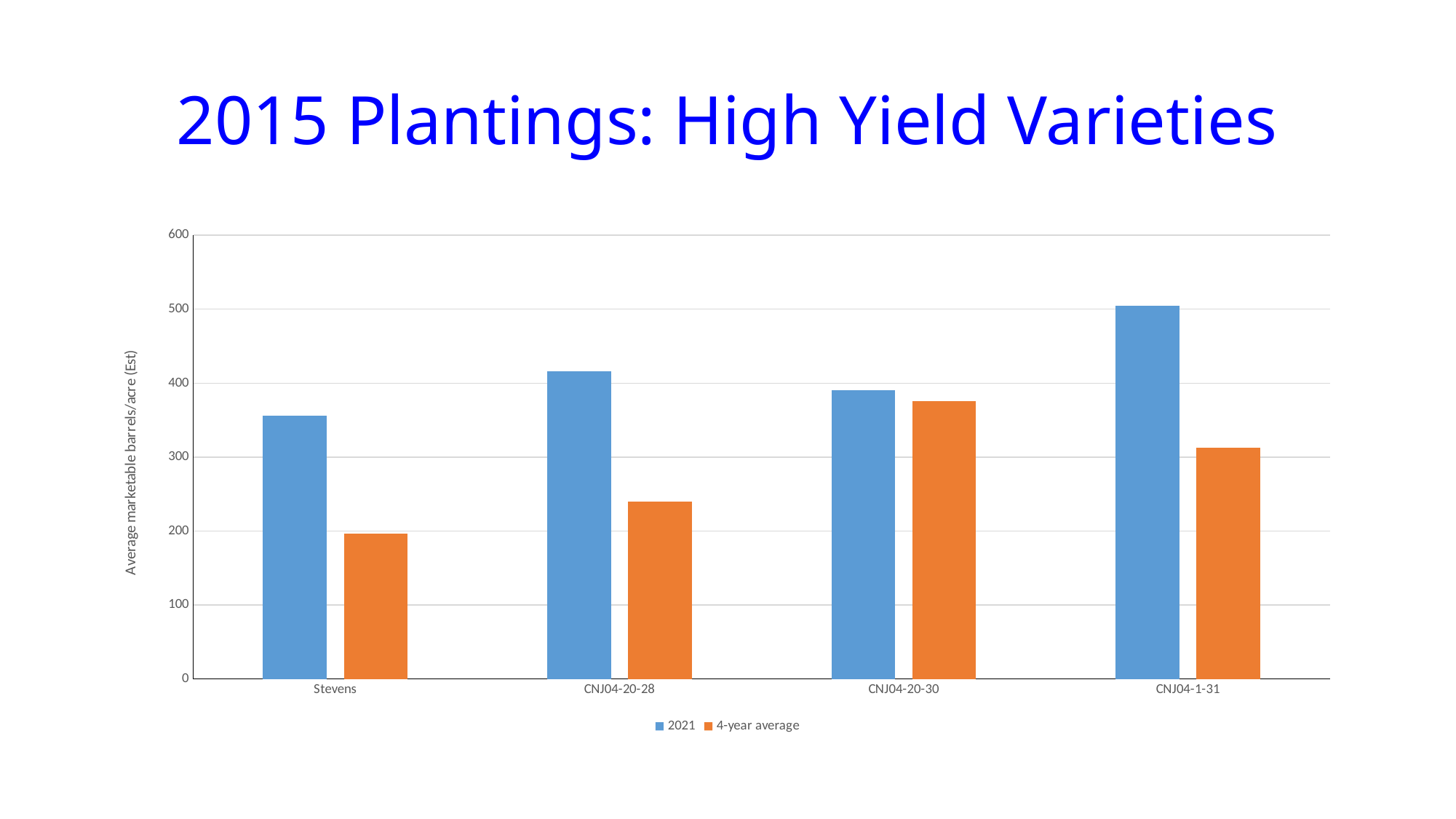
What kind of chart is shown on the slide? bar chart Which variety has the lowest 4-year average value? Stevens Which is larger: the 2021 value for Stevens or the 2021 value for CNJ04-20-28? CNJ04-20-28 How many series does the legend list? 2 Which variety has the lowest 2021 value? Stevens Which variety has the highest 4-year average value? CNJ04-20-30 Which variety has the highest 2021 value? CNJ04-1-31 How many varieties are shown on the x axis of the chart? 4 Is the 4-year average value for CNJ04-1-31 greater or less than 400? less What is the title of the chart slide? 2015 Plantings: High Yield Varieties Is the 4-year average value for Stevens greater or less than 300? less Is the 2021 value for CNJ04-1-31 greater or less than 400? greater